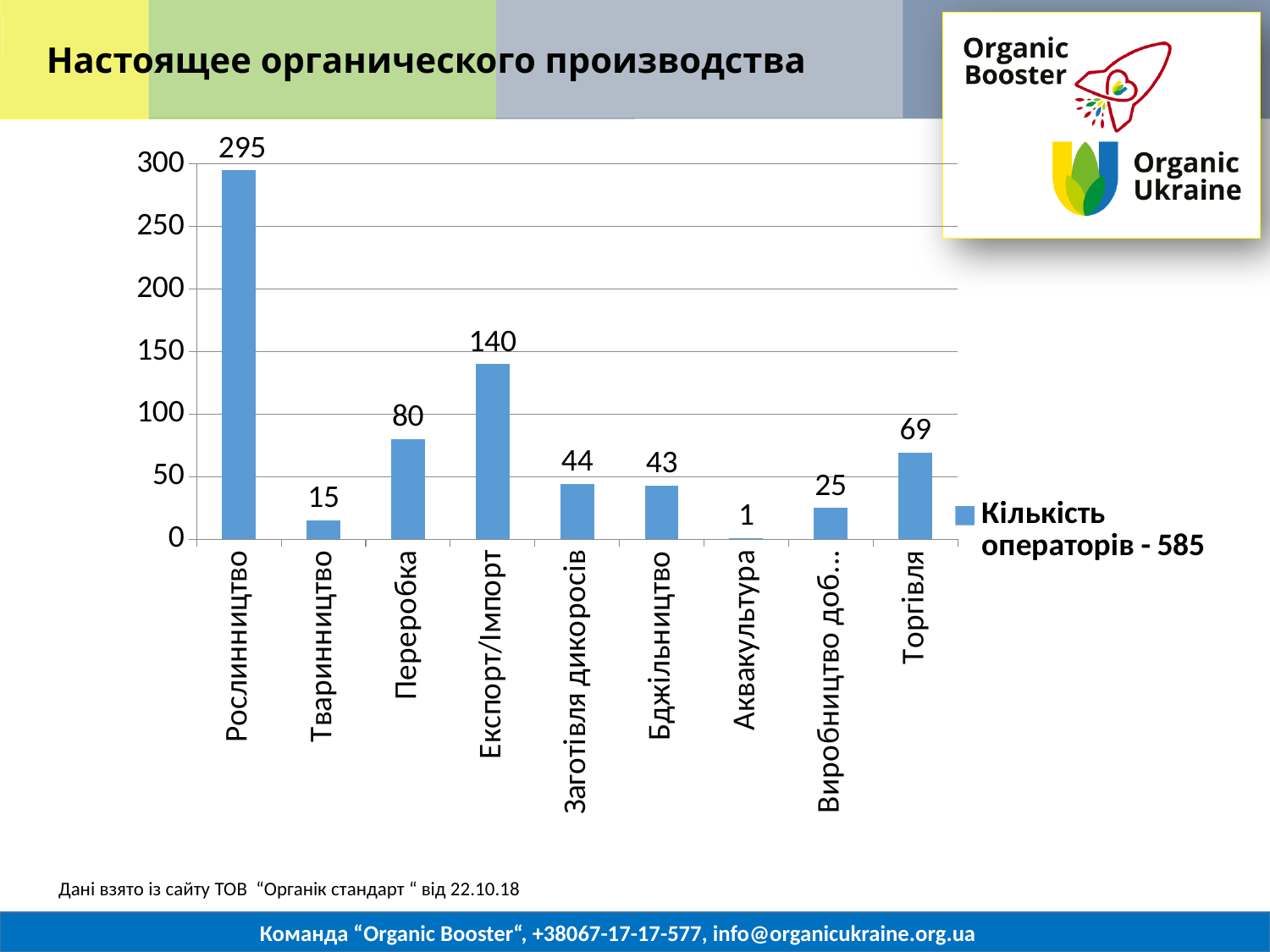
What is the difference between the values for Рослинництво and Експорт/Імпорт? 155 What kind of chart is shown on the slide? bar chart Which category has the lowest value? Аквакультура What is the value for Торгівля? 69 Which is larger, the value for Переробка or the value for Торгівля? Переробка What is the value for Рослинництво? 295 What is the legend entry of the chart? Кількість операторів - 585 Which category has the highest value? Рослинництво What is the value for Аквакультура? 1 How many categories are shown on the x axis? 9 Is the value for Тваринництво greater or less than 50? less What is the value for Експорт/Імпорт? 140